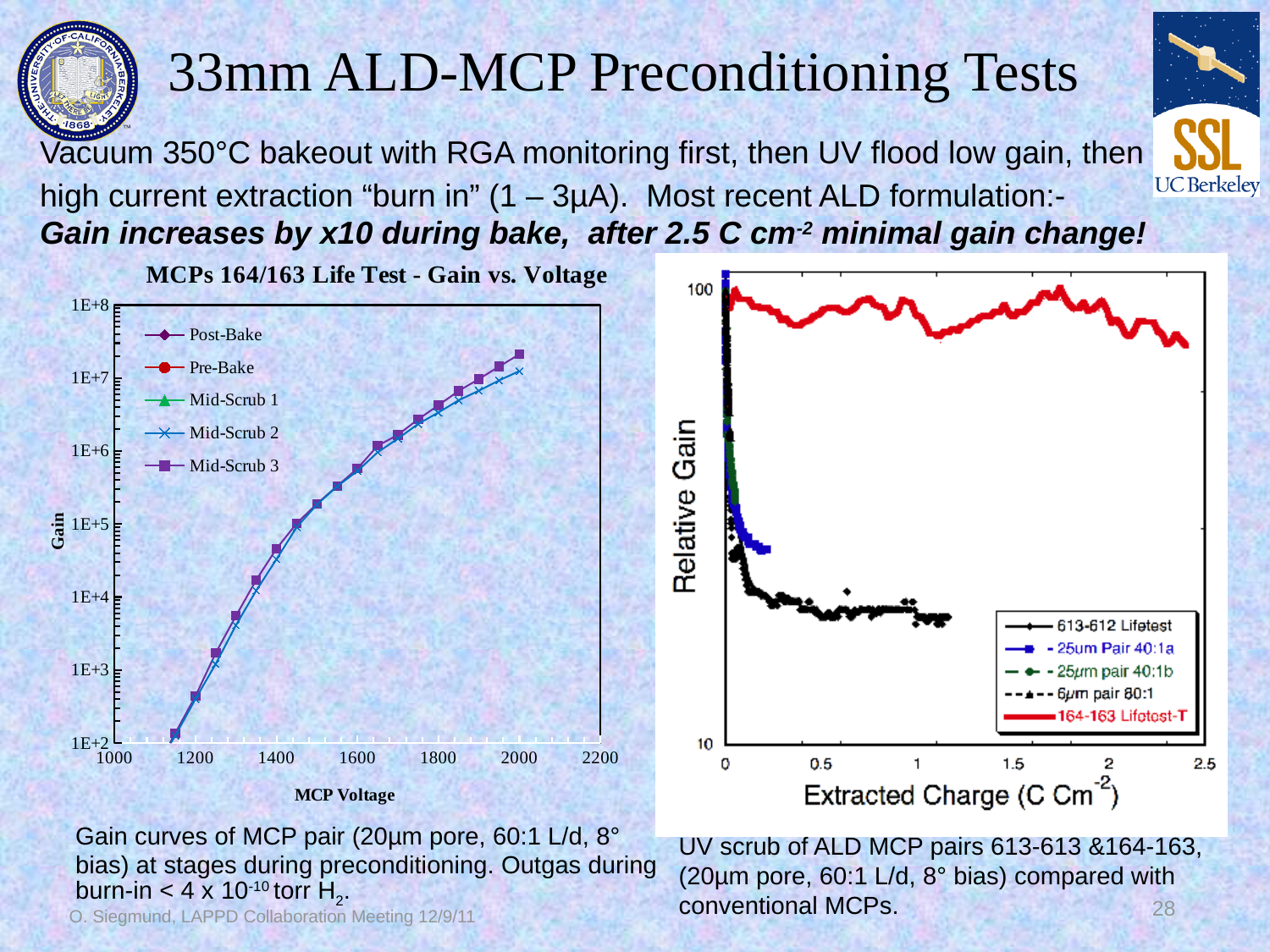
In the right chart (Relative Gain vs. Extracted Charge), which series is drawn in red? 164-163 Lifetest-T In the right chart (Relative Gain vs. Extracted Charge), is the relative gain of the 613-612 Lifetest series at 1 C cm-2 greater or less than 100? less In the left chart (Gain vs. Voltage), how many series does the legend list? 5 What kind of chart is the left chart (Gain vs. Voltage)? line chart In the left chart (Gain vs. Voltage), is the gain at 1600 V greater or less than 1E+5? greater What is the title of the chart on the left of the slide? MCPs 164/163 Life Test - Gain vs. Voltage In the right chart (Relative Gain vs. Extracted Charge), does the relative gain of the 613-612 Lifetest series rise or fall as extracted charge increases? fall In the right chart (Relative Gain vs. Extracted Charge), how many series does the legend list? 5 In the left chart (Gain vs. Voltage), is the gain at 1200 V greater or less than 1E+3? less In the right chart (Relative Gain vs. Extracted Charge), at 1 C cm-2, which series has the higher relative gain: 164-163 Lifetest-T or 613-612 Lifetest? 164-163 Lifetest-T In the left chart (Gain vs. Voltage), does the gain rise or fall as MCP Voltage increases? rise